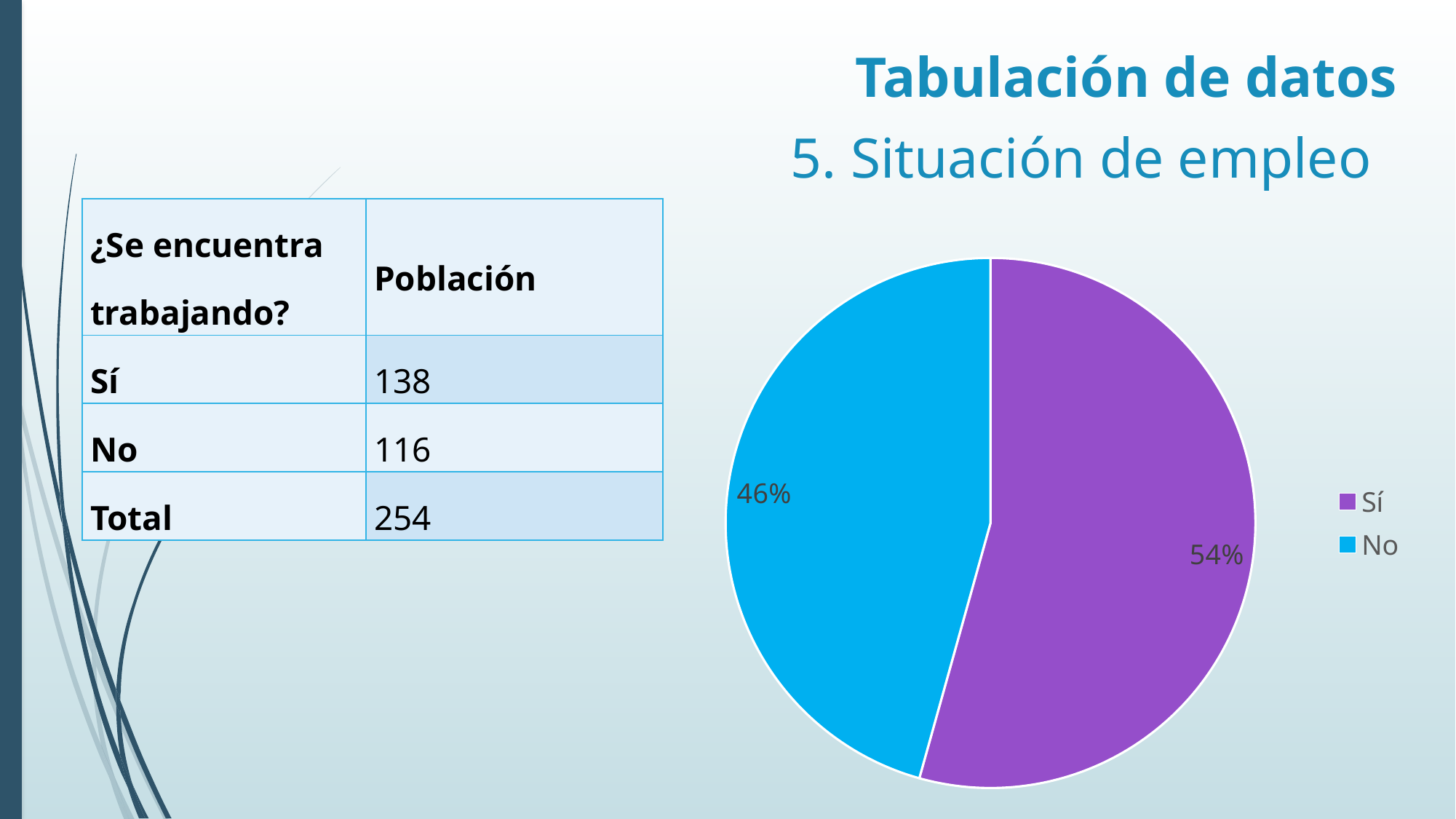
Which slice of the pie chart is the smallest? No What is the difference in percentage points between the "Sí" and "No" slices? 8% Which is larger in the pie chart, the "Sí" slice or the "No" slice? Sí What share of the pie does the "Sí" slice represent? 54% Which slice of the pie chart is the largest? Sí What colour is the "Sí" slice in the pie chart? purple What kind of chart is shown on the slide? pie chart What colour is the "No" slice in the pie chart? blue How many entries does the legend of the pie chart list? 2 How many slices does the pie chart have? 2 Is the share of the "No" slice greater or less than 50%? less What share of the pie does the "No" slice represent? 46%